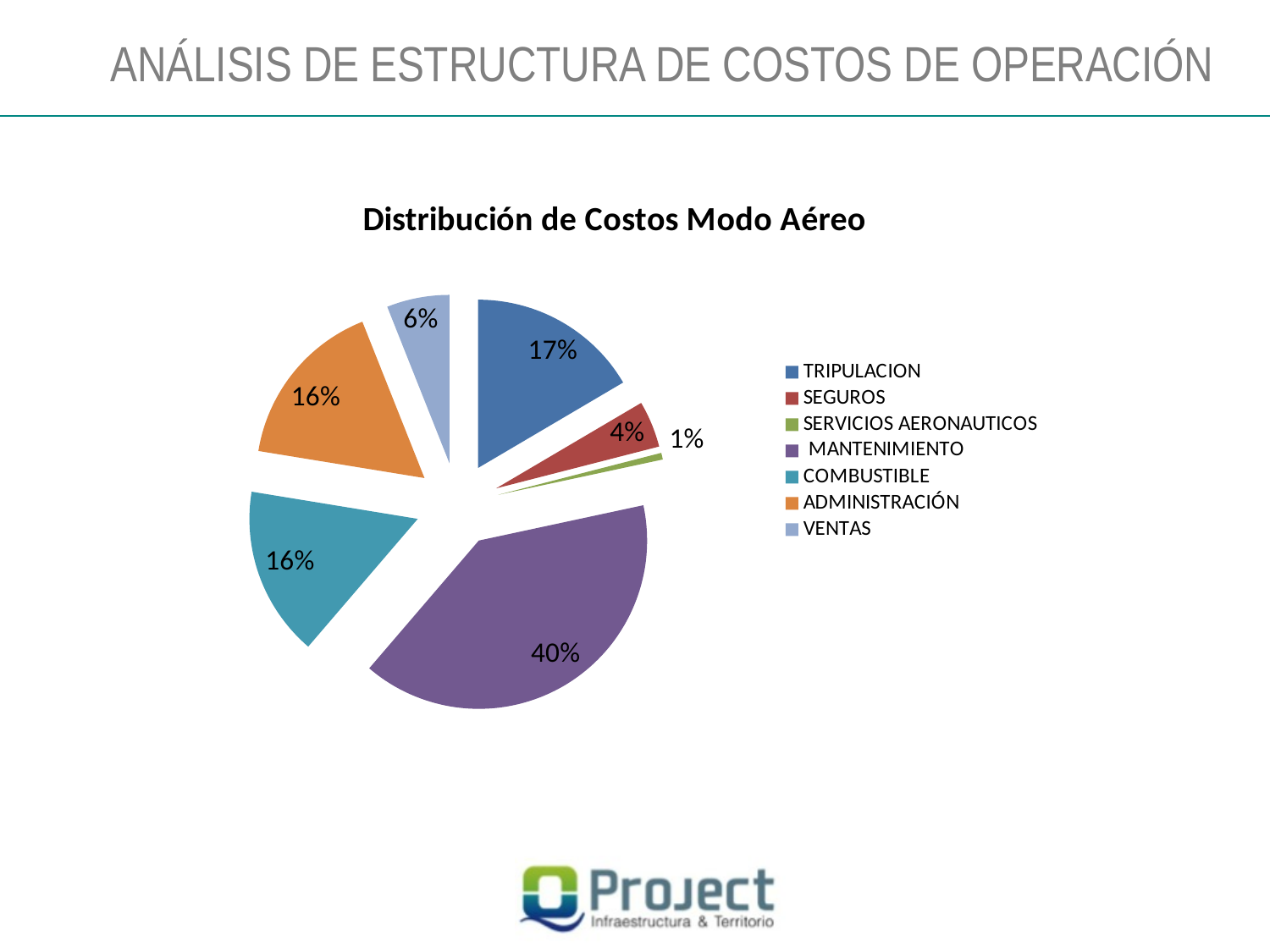
What type of chart is shown on the slide? Pie chart What is the difference between the shares of MANTENIMIENTO and TRIPULACION? 23% Which category has the smallest share of the pie? SERVICIOS AERONAUTICOS What share of costs does VENTAS represent? 6% How many categories does the legend list? 7 What share of costs does MANTENIMIENTO represent? 40% What share of costs does SEGUROS represent? 4% What is the title of the chart? Distribución de Costos Modo Aéreo Which is larger, the share for TRIPULACION or the share for VENTAS? TRIPULACION Which category has the largest share of the pie? MANTENIMIENTO